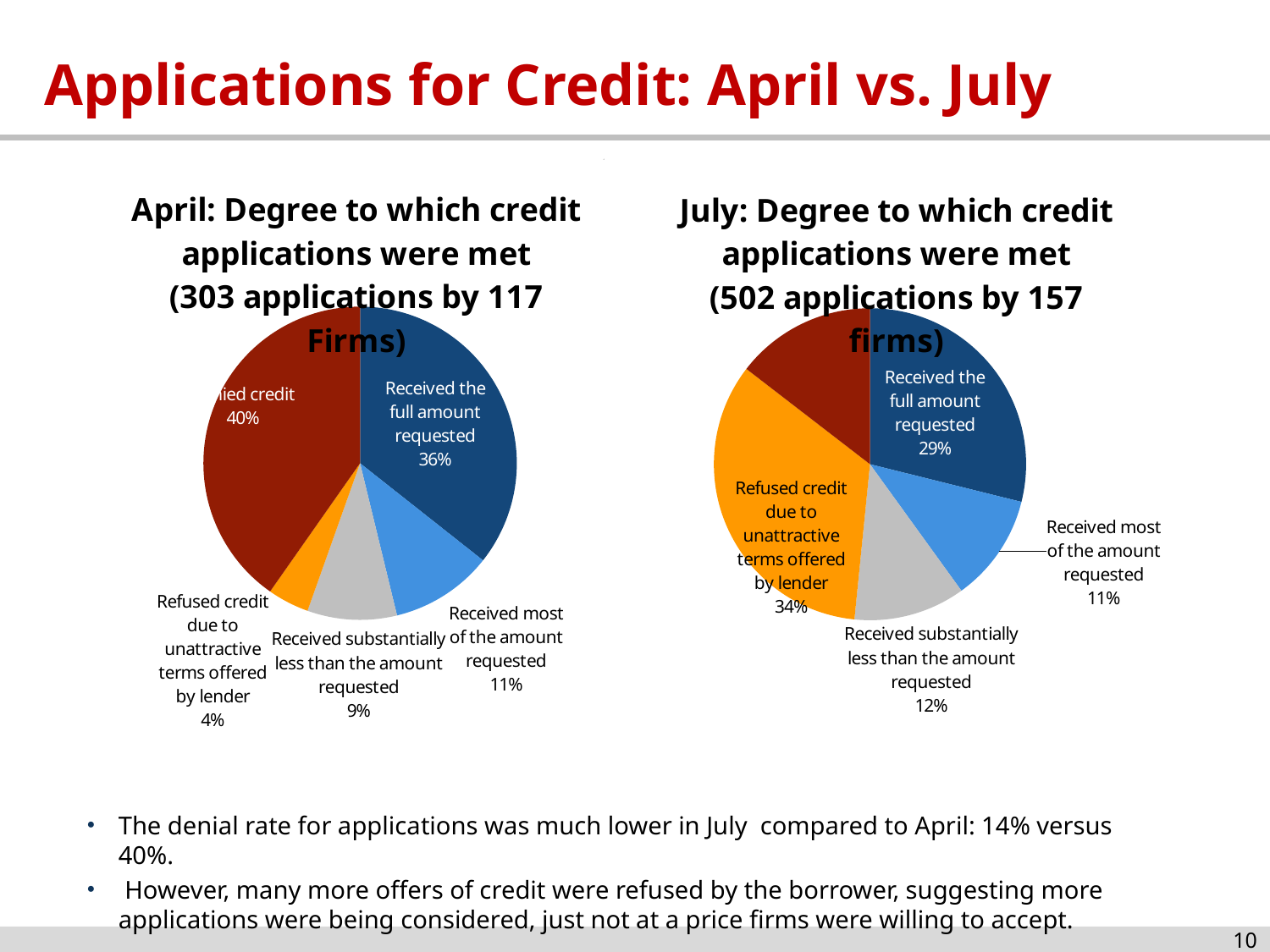
In the July pie chart, what share received substantially less than the amount requested? 12% What is the difference between the April and July shares of applications that received the full amount requested? 7% In the July pie chart, which is larger: received most of the amount requested or received substantially less than the amount requested? Received substantially less than the amount requested How many slices does the April pie chart have? 5 In the April pie chart, what share of applications received most of the amount requested? 11% In the April pie chart, which category has the smallest share? Refused credit due to unattractive terms offered by lender In the July pie chart, what share of applications received the full amount requested? 29% What type of chart is used for the April data? Pie chart In the April pie chart, what percentage of applications refused credit due to unattractive terms offered by lender? 4% In the July pie chart, what percentage of applications refused credit due to unattractive terms offered by lender? 34% In the April pie chart, what share of applications received the full amount requested? 36% In the April pie chart, what share received substantially less than the amount requested? 9%